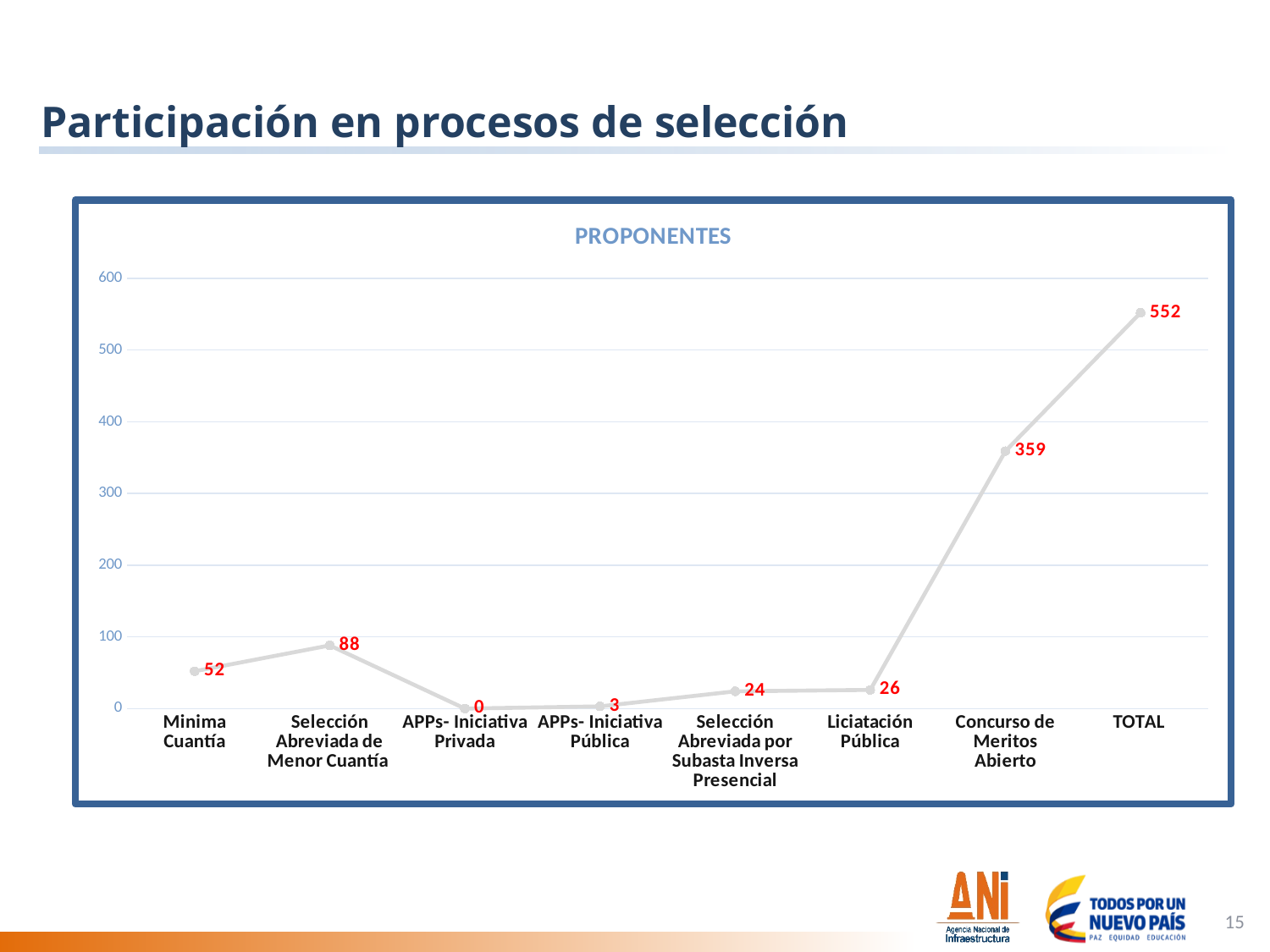
What kind of chart is this? line chart What is the difference between the values for Selección Abreviada de Menor Cuantía and Minima Cuantía? 36 What is the value for Selección Abreviada por Subasta Inversa Presencial? 24 Which category has the lowest value? APPs- Iniciativa Privada What is the value for Minima Cuantía? 52 What is the title of the chart? PROPONENTES Excluding TOTAL, which category has the highest value? Concurso de Meritos Abierto What is the value for TOTAL? 552 Is the value for Concurso de Meritos Abierto greater or less than 300? greater What is the value for Concurso de Meritos Abierto? 359 Which is larger, the value for Liciatación Pública or the value for APPs- Iniciativa Pública? Liciatación Pública How many categories are shown on the x axis? 8